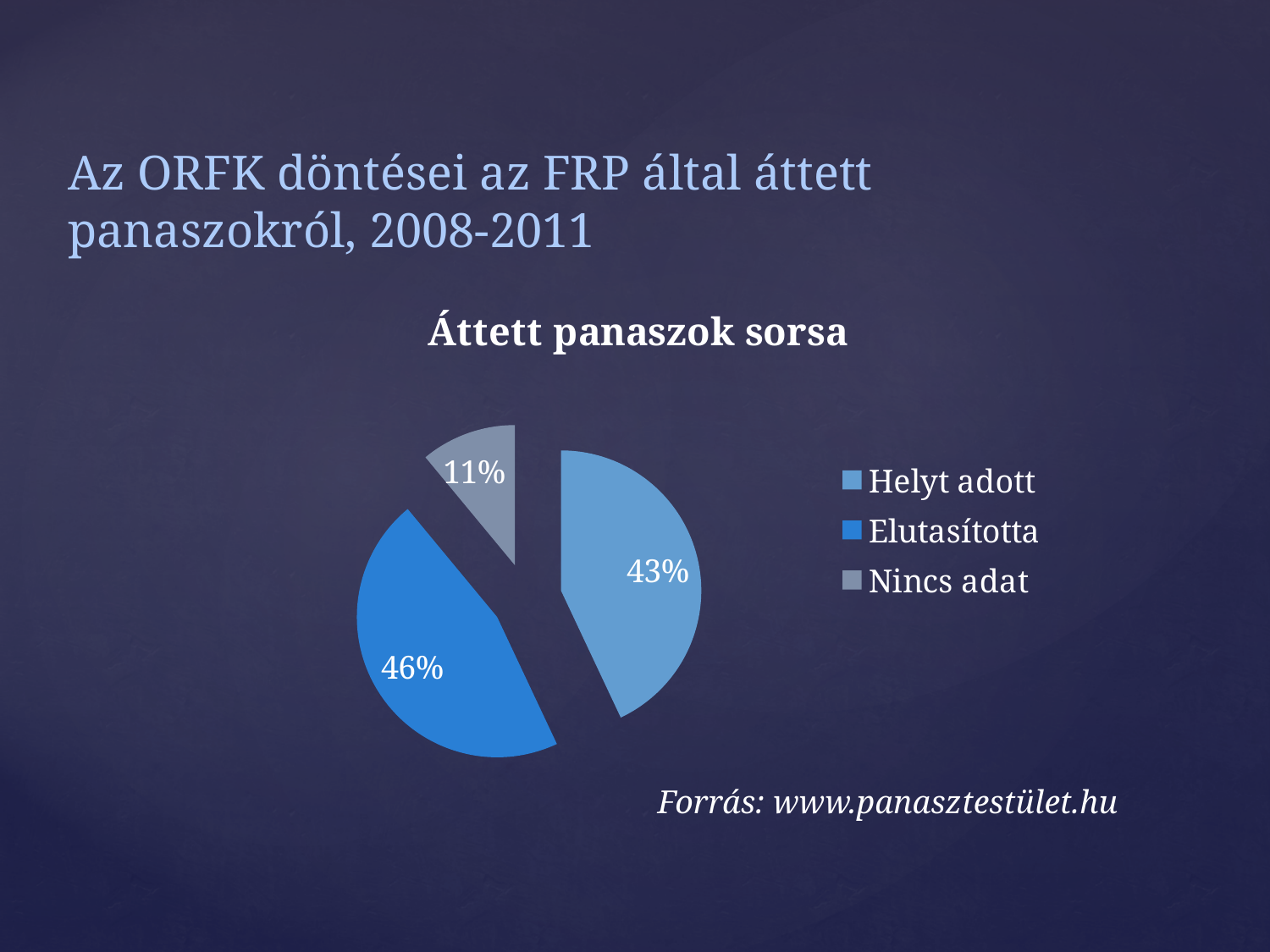
Which category has the smallest slice of the pie? Nincs adat What share of the pie does "Elutasította" represent? 46% What share of the pie does "Nincs adat" represent? 11% What is the title of the chart? Áttett panaszok sorsa Which category has the largest slice of the pie? Elutasította What share of the pie does "Helyt adott" represent? 43% How many entries does the legend list? 3 Which is larger, the share for "Helyt adott" or the share for "Elutasította"? Elutasította What is the difference in percentage points between the "Helyt adott" and "Nincs adat" slices? 32 percentage points How many slices does the pie chart have? 3 What kind of chart is shown on the slide? pie chart What is the difference in percentage points between the "Elutasította" and "Helyt adott" slices? 3 percentage points